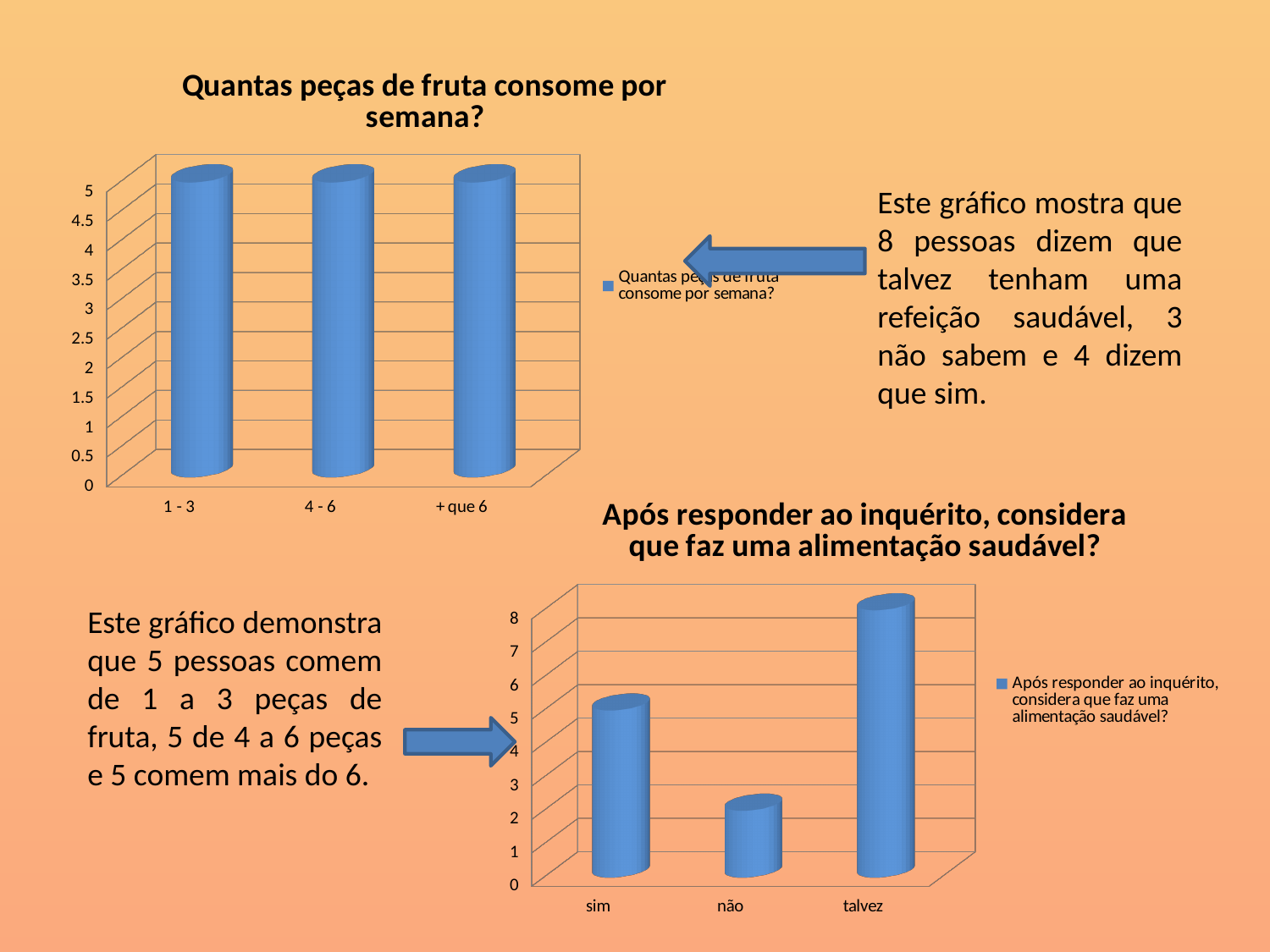
In the chart titled "Após responder ao inquérito, considera que faz uma alimentação saudável?", what is the difference between the values for "talvez" and "sim"? 3 In the chart titled "Após responder ao inquérito, considera que faz uma alimentação saudável?", which is larger, the value for "sim" or the value for "não"? sim In the chart titled "Após responder ao inquérito, considera que faz uma alimentação saudável?", what is the value for "talvez"? 8 In the chart titled "Após responder ao inquérito, considera que faz uma alimentação saudável?", what is the value for "não"? 2 In the chart titled "Quantas peças de fruta consome por semana?", do the values rise, fall, or stay the same across the categories? stay the same In the chart titled "Quantas peças de fruta consome por semana?", what is the value for "1 - 3"? 5 In the chart titled "Após responder ao inquérito, considera que faz uma alimentação saudável?", is the value for "talvez" greater or less than 6? greater In the chart titled "Após responder ao inquérito, considera que faz uma alimentação saudável?", which category has the highest value? talvez In the chart titled "Após responder ao inquérito, considera que faz uma alimentação saudável?", which category has the lowest value? não In the chart titled "Após responder ao inquérito, considera que faz uma alimentação saudável?", how many series does the legend list? 1 In the chart titled "Quantas peças de fruta consome por semana?", what kind of chart is it? bar chart In the chart titled "Quantas peças de fruta consome por semana?", how many categories are shown on the x axis? 3